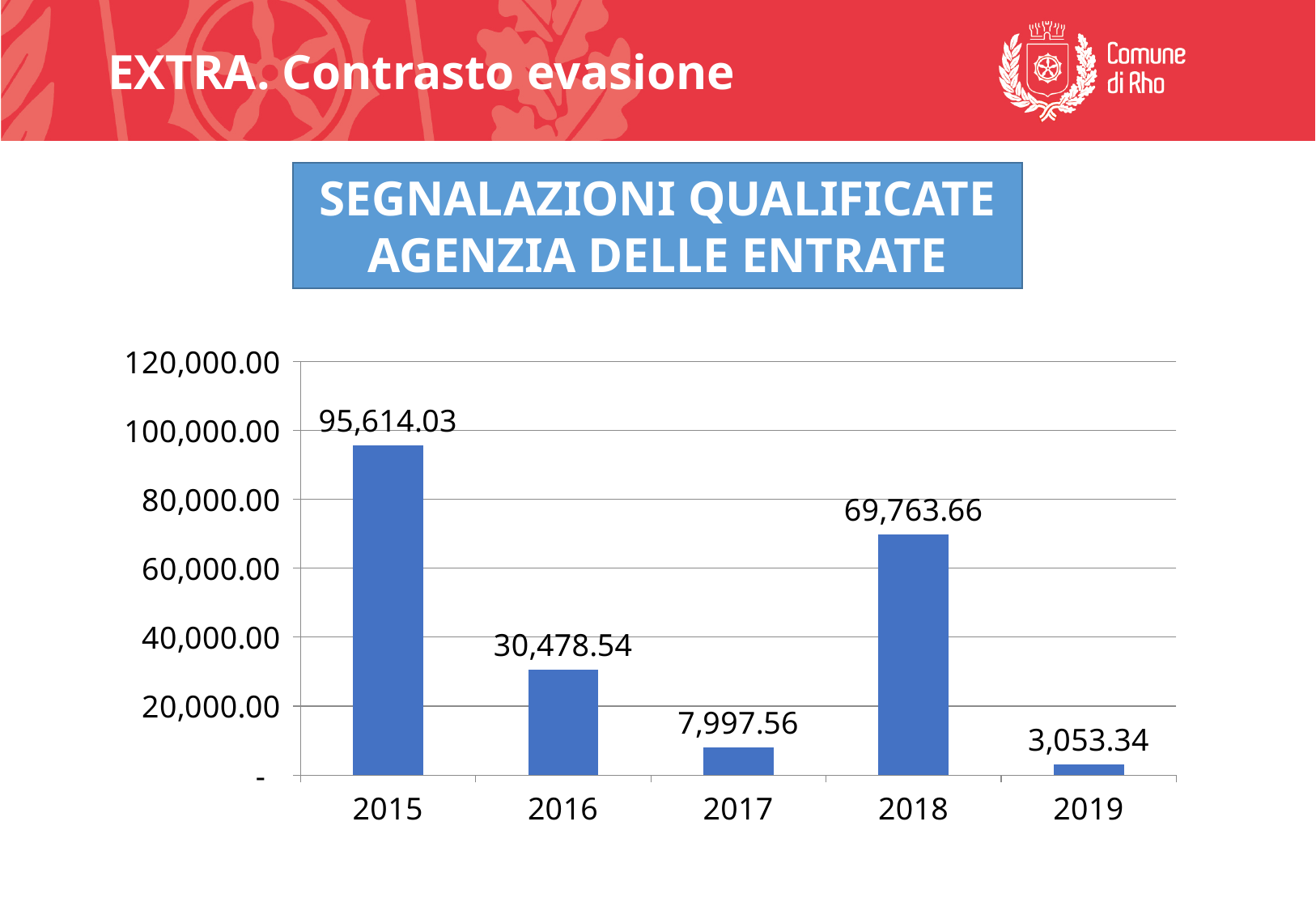
What kind of chart is shown? bar chart What is the value for 2017? 7,997.56 Which is larger, the value for 2016 or the value for 2018? 2018 Which year has the highest value? 2015 Which year has the lowest value? 2019 What is the difference between the values for 2015 and 2018? 25,850.37 What is the value for 2019? 3,053.34 What is the value for 2015? 95,614.03 What is the difference between the values for 2016 and 2017? 22,480.98 Do the values rise or fall from 2015 to 2017? fall How many years are shown on the x axis? 5 Is the value for 2018 greater or less than 60,000.00? greater